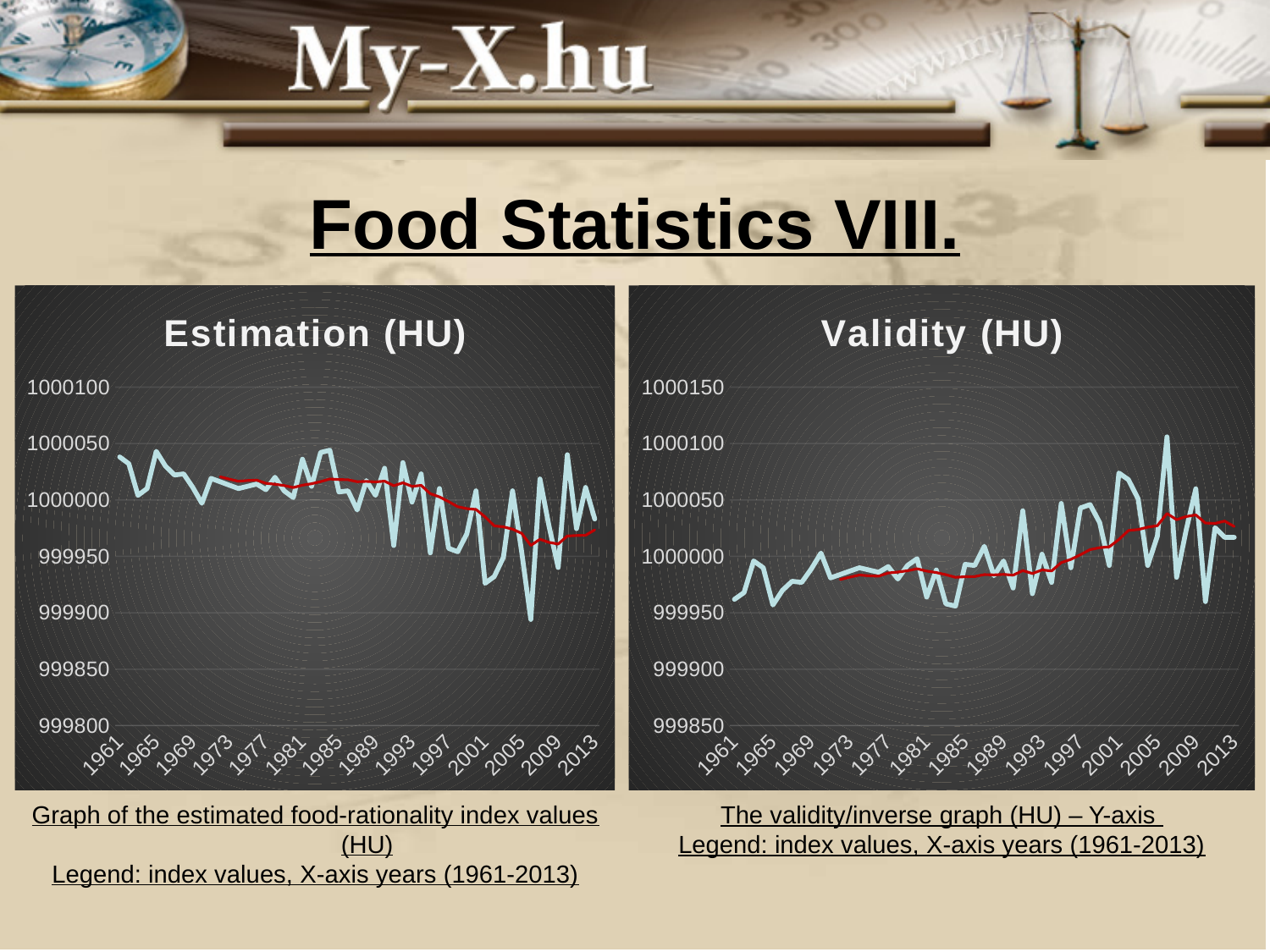
In the "Estimation (HU)" chart, is the value for 1961 greater or less than 1000000? greater In the "Validity (HU)" chart, is the highest peak of the light blue line greater or less than 1000050? greater How many lines are plotted in the "Estimation (HU)" chart? 2 In the "Validity (HU)" chart, is the value for 1961 greater or less than 1000000? less What kind of chart is the "Validity (HU)" chart? line chart What is the title of the chart on the left side of the slide? Estimation (HU) In the "Validity (HU)" chart, do the values generally rise or fall from 1961 to 2013? rise What is the lowest value shown on the y-axis of the "Validity (HU)" chart? 999850 In the "Estimation (HU)" chart, do the values generally rise or fall from 1961 to 2013? fall What kind of chart is the "Estimation (HU)" chart? line chart How many charts are shown on the slide? 2